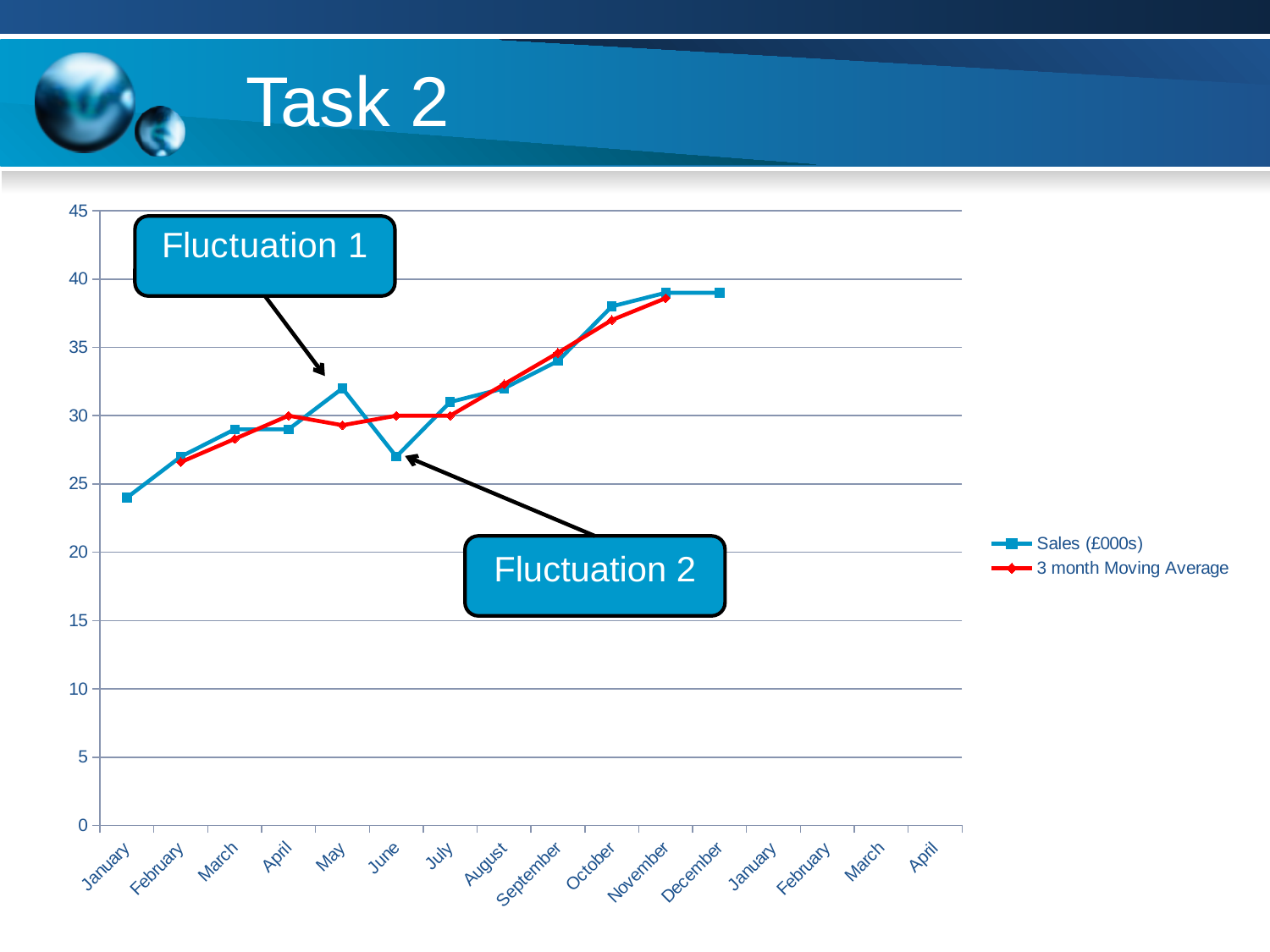
Is the Sales (£000s) value for January greater or less than 25? less Is the Sales (£000s) value for October greater or less than 35? greater How many month categories are shown along the x axis? 16 Is the Sales (£000s) value for May greater or less than 30? greater What is the 3 month Moving Average value for April? 30 How many series does the legend list? 2 Do the Sales (£000s) values generally rise or fall from January to December? rise Which month has the lowest Sales (£000s) value? January What are the two series named in the legend? Sales (£000s) and 3 month Moving Average Which is larger, the Sales (£000s) value for May or for June? May What kind of chart is shown on the slide? line chart